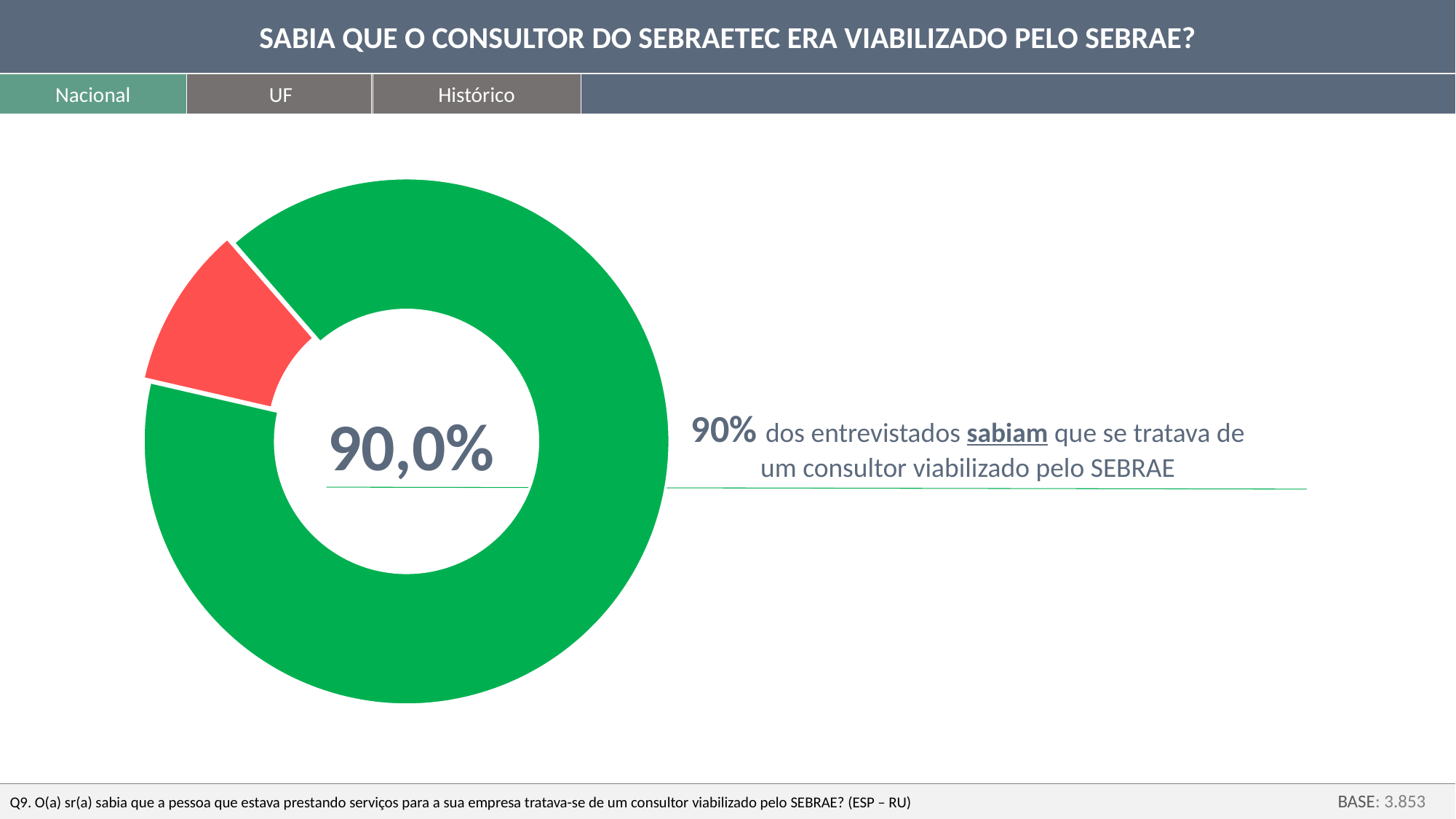
What kind of chart is shown on the slide? pie chart (donut) Which colour slice is the largest in the donut chart? green Which colour slice is the smallest in the donut chart? red What is the title of the slide containing the chart? SABIA QUE O CONSULTOR DO SEBRAETEC ERA VIABILIZADO PELO SEBRAE? What value is printed in the centre of the donut chart? 90,0% How many slices does the donut chart have? 2 Which slice of the donut chart is larger, the green one or the red one? green What share of the donut chart does the green slice represent? 90,0% According to the text next to the chart, what percentage of respondents knew the consultant was made available by SEBRAE? 90% What is the base (number of respondents) shown at the bottom right of the slide? 3.853